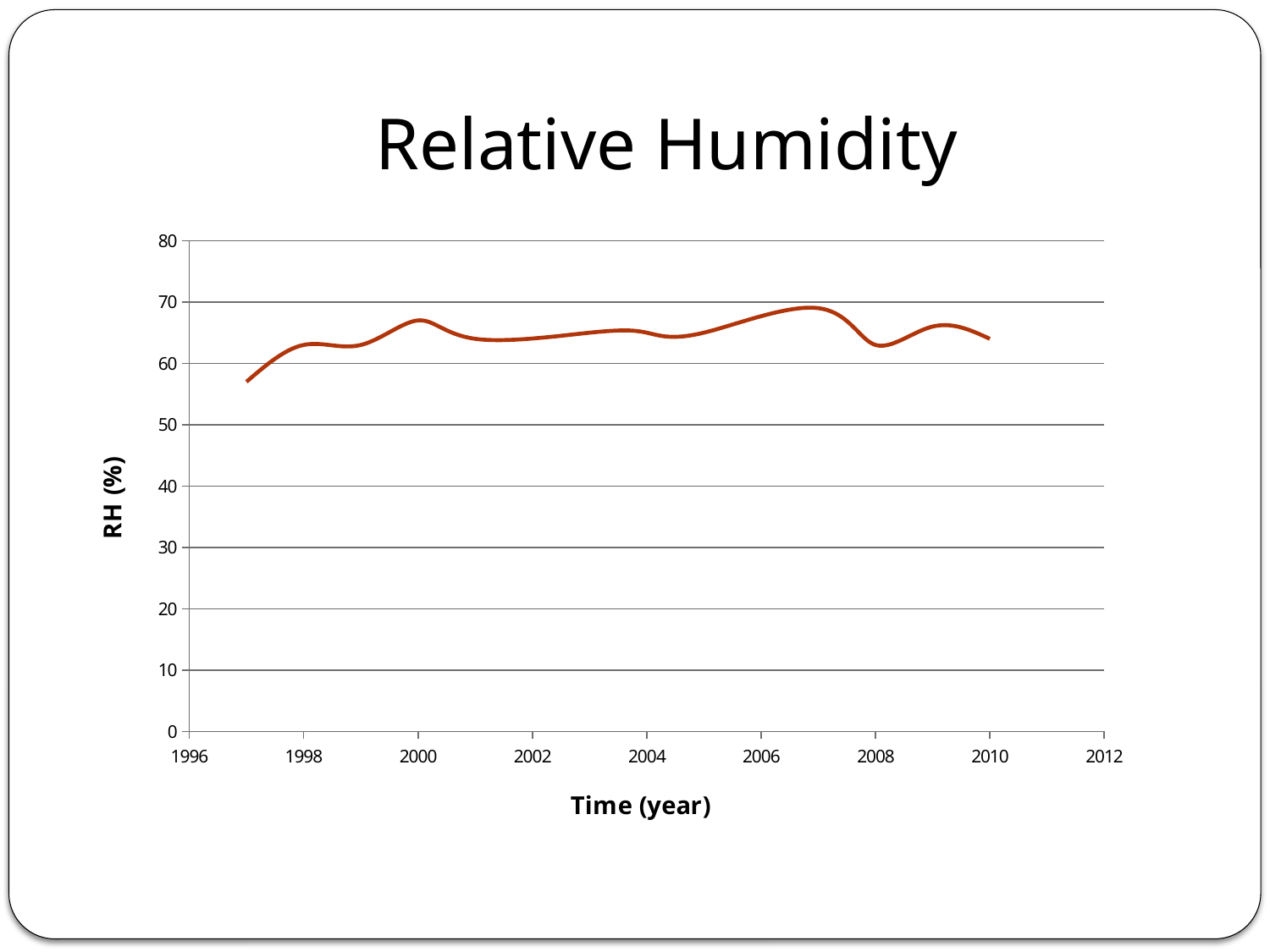
Does the relative humidity rise or fall between 1997 and 1998? rise What is the title of the chart? Relative Humidity Is the RH value for 1997 greater or less than 60? less Is the RH value for 2008 greater or less than 50? greater Does the relative humidity rise or fall between 2007 and 2008? fall What kind of chart is shown on the slide? line chart Which year has the higher RH value, 1997 or 2007? 2007 What is the label of the vertical axis? RH (%) Is the RH value for 2010 greater or less than 60? greater In which year is the relative humidity lowest? 1997